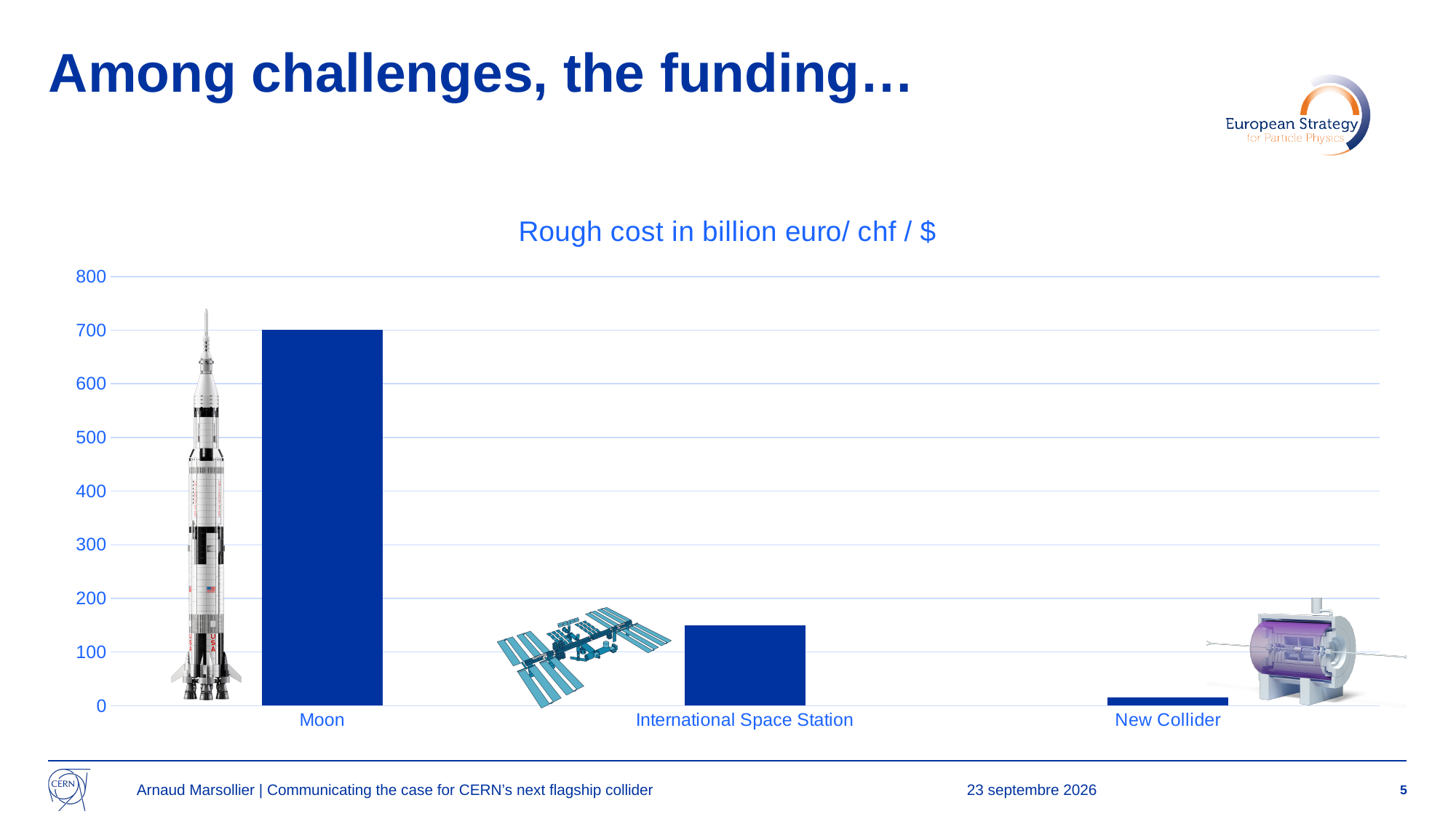
What kind of chart is shown on the slide? bar chart Is the value for International Space Station greater or less than 100? greater Which has a larger rough cost, Moon or International Space Station? Moon What is the rough cost shown for Moon? 700 Is the value for International Space Station greater or less than 200? less Which has a larger rough cost, International Space Station or New Collider? International Space Station Do the values rise or fall from left to right across the categories? fall How many categories are plotted in the chart? 3 Is the value for New Collider greater or less than 100? less Which category has the lowest rough cost? New Collider What is the title of the chart? Rough cost in billion euro/ chf / $ Which category has the highest rough cost? Moon